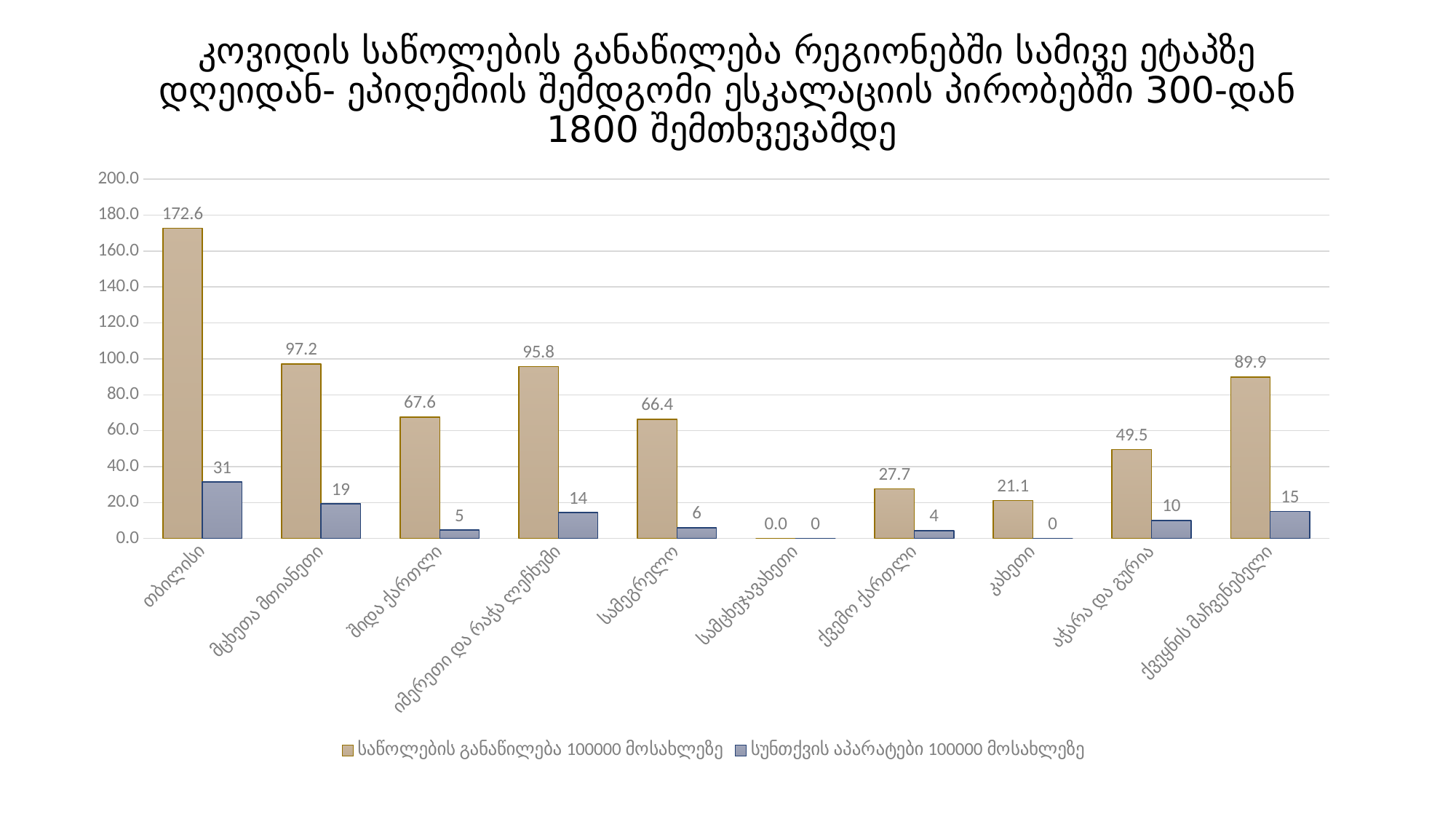
What kind of chart is shown on the slide? bar chart Which category has the highest value for საწოლების განაწილება 100000 მოსახლეზე? თბილისი How many series does the legend list? 2 What is the difference between the საწოლების განაწილება 100000 მოსახლეზე values for თბილისი and მცხეთა მთიანეთი? 75.4 What is the value of საწოლების განაწილება 100000 მოსახლეზე for ქვეყნის მაჩვენებელი? 89.9 How many categories are shown on the x axis? 10 Which is larger: the სუნთქვის აპარატები 100000 მოსახლეზე value for იმერეთი და რაჭა ლეჩხუმი or for აჭარა და გურია? იმერეთი და რაჭა ლეჩხუმი Is the საწოლების განაწილება 100000 მოსახლეზე value for შიდა ქართლი greater or less than 80.0? less What is the difference between the სუნთქვის აპარატები 100000 მოსახლეზე values for თბილისი and ქვეყნის მაჩვენებელი? 16 What is the value of საწოლების განაწილება 100000 მოსახლეზე for თბილისი? 172.6 What is the value of სუნთქვის აპარატები 100000 მოსახლეზე for მცხეთა მთიანეთი? 19 Which category has the lowest value for საწოლების განაწილება 100000 მოსახლეზე? სამცხეჯავახეთი